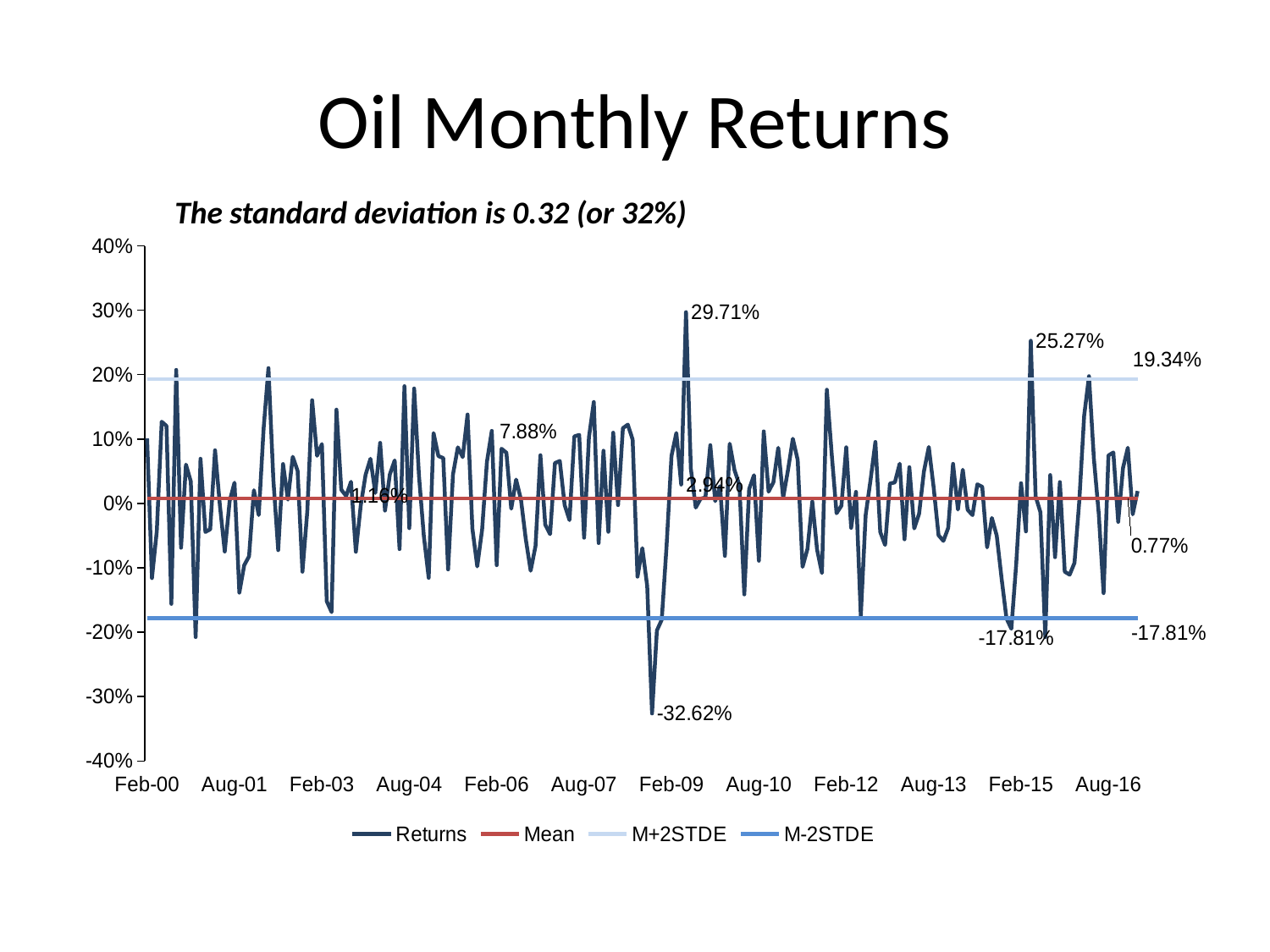
What is the highest labelled monthly return on the chart? 29.71% What is the difference between the M+2STDE value (19.34%) and the M-2STDE value (-17.81%)? 37.15 percentage points How many series does the legend list? 4 What are the four series named in the legend? Returns, Mean, M+2STDE, M-2STDE What value is labelled for the M+2STDE line? 19.34% Which is larger, the labelled peak of 29.71% near Feb-09 or the labelled peak of 25.27% near Feb-15? 29.71% Is the Mean line greater or less than 10%? less What value is labelled for the M-2STDE line? -17.81% According to the text above the chart, what is the standard deviation? 0.32 (or 32%) What kind of chart is shown on the slide? Line chart What is the lowest labelled monthly return on the chart? -32.62% What is the difference between the highest labelled return (29.71%) and the lowest labelled return (-32.62%)? 62.33 percentage points